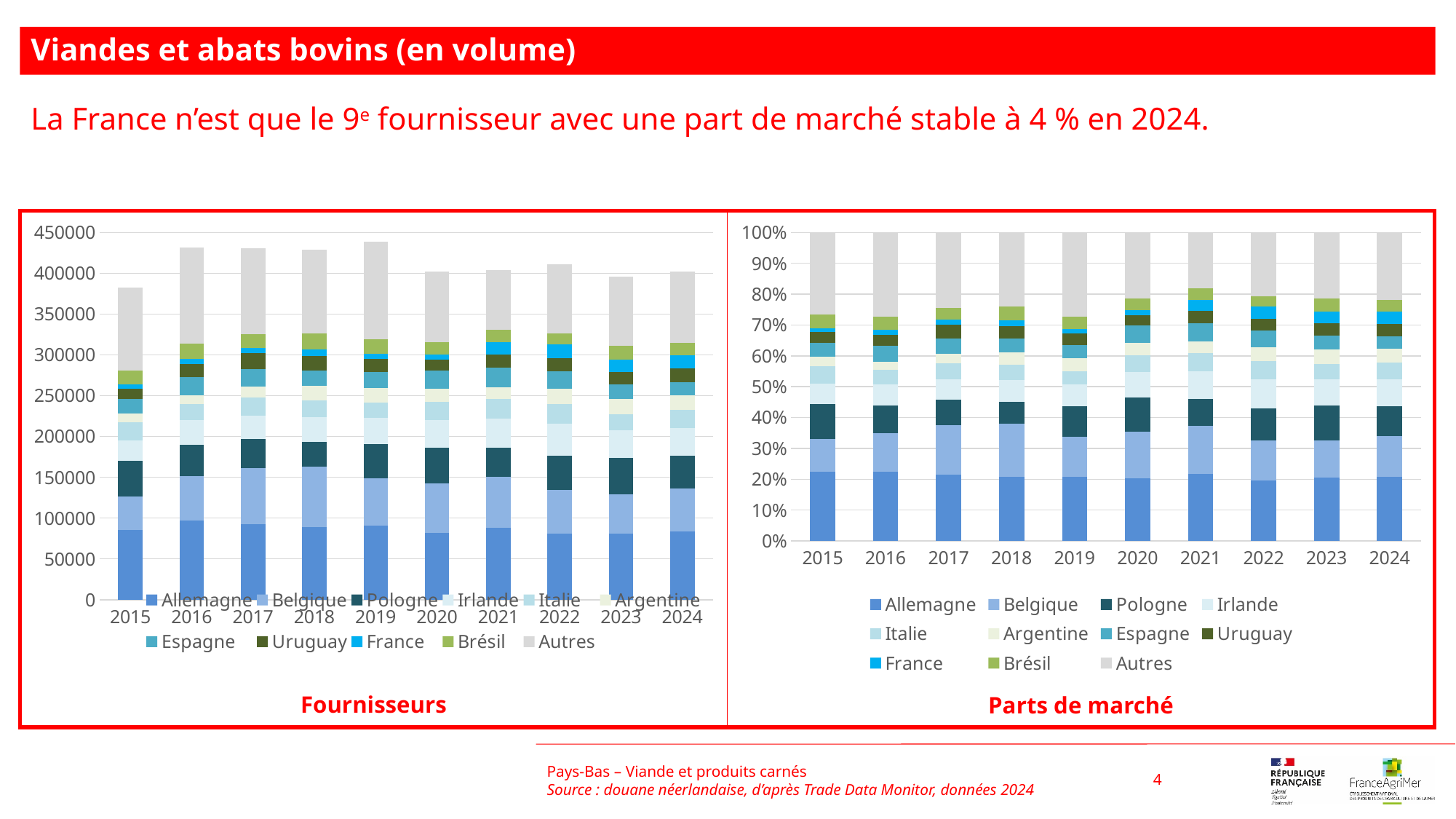
In the 'Fournisseurs' chart, is the total for 2019 greater or less than 400000? greater In the 'Fournisseurs' chart, is the total for 2015 greater or less than 400000? less In the 'Fournisseurs' chart, does the total rise or fall from 2019 to 2020? fall In the 'Fournisseurs' chart, which year has the lowest total bar? 2015 How many series does the legend of the 'Fournisseurs' chart list? 11 How many years are shown on the x axis of the 'Parts de marché' chart? 10 In the 'Parts de marché' chart, is the share of Allemagne in 2015 greater or less than 20%? greater In the 'Fournisseurs' chart, which is larger in 2015: the Allemagne segment or the Belgique segment? Allemagne What is the title shown under the right-hand chart? Parts de marché What kind of chart is the 'Fournisseurs' chart on the left? Stacked bar chart